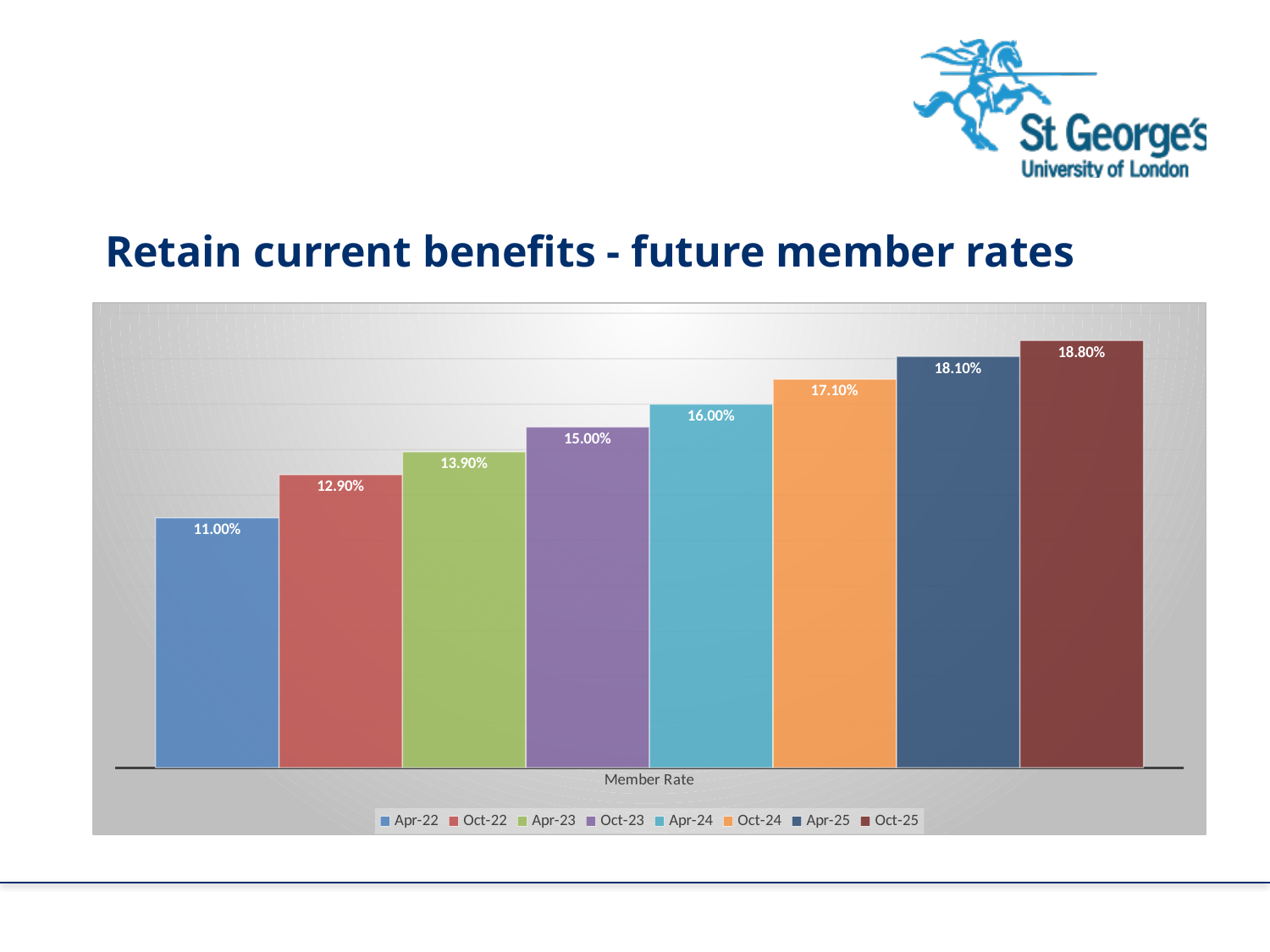
How many series does the legend list? 8 What is the member rate for Apr-24? 16.00% What is the label shown on the x axis of the chart? Member Rate What is the difference between the member rates for Oct-22 and Apr-23? 1.00% Which period has the highest member rate? Oct-25 Do the member rates rise or fall from Apr-22 to Oct-25? Rise What kind of chart is shown on the slide? Bar chart What is the difference between the member rates for Oct-25 and Apr-22? 7.80% What is the member rate for Apr-22? 11.00% Which period has the lowest member rate? Apr-22 Which is larger, the member rate for Oct-23 or for Apr-25? Apr-25 What is the member rate for Oct-24? 17.10%